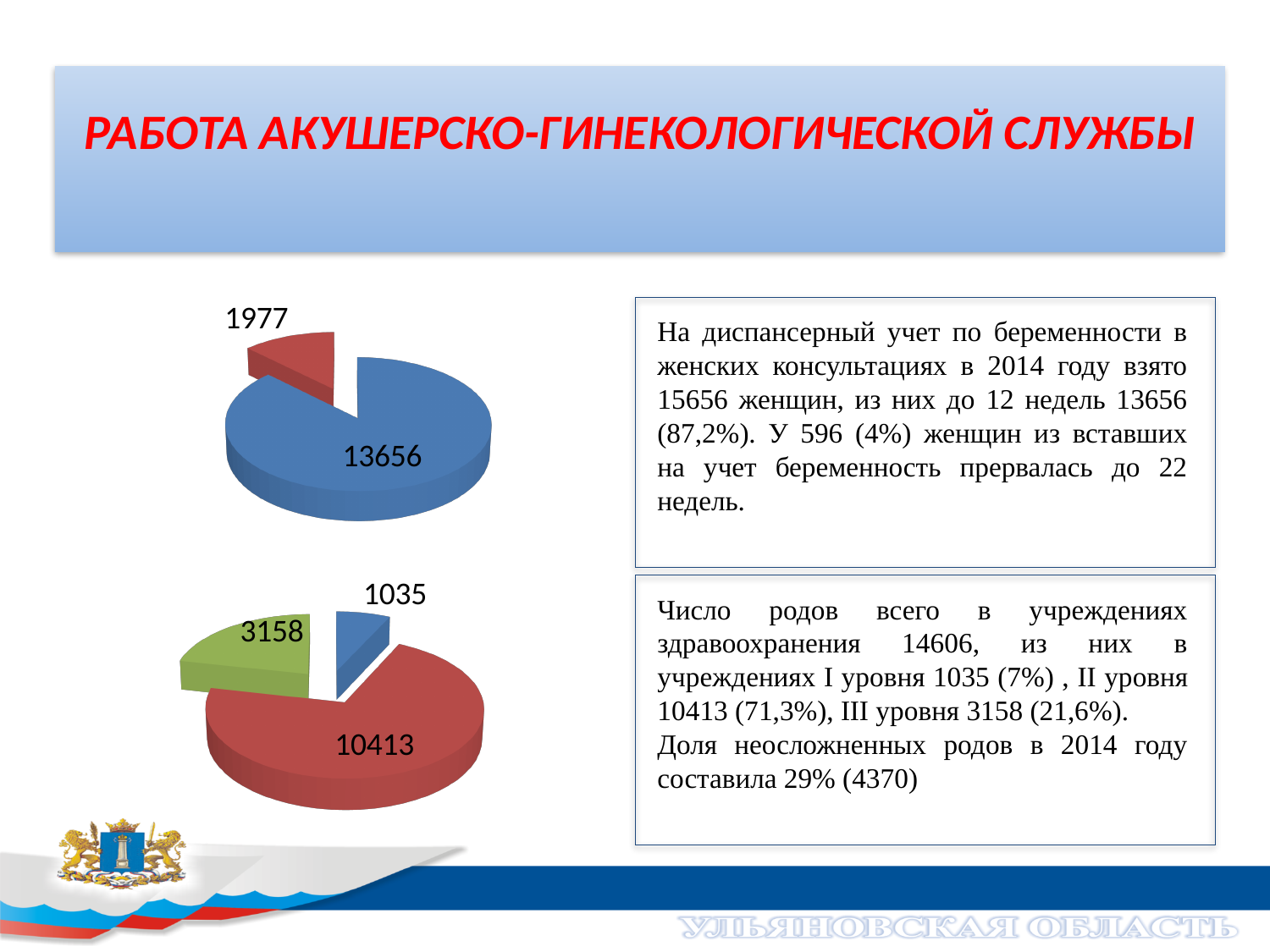
What type of chart is the top chart on the slide? pie chart In the top pie chart, what is the difference between the blue slice value and the red slice value? 11679 How many slices does the bottom pie chart have? 3 In the bottom pie chart, what is the total of all three slice values? 14606 In the bottom pie chart, what value is shown for the red slice? 10413 In the bottom pie chart, is the green slice (3158) larger or smaller than the blue slice (1035)? larger In the bottom pie chart, what value is shown for the green slice? 3158 In the top pie chart, what value is shown for the blue slice? 13656 How many slices does the top pie chart have? 2 In the bottom pie chart, which slice has the smallest value? the blue slice (1035) In the top pie chart, what value is shown for the red slice? 1977 In the bottom pie chart, which slice has the largest value? the red slice (10413)